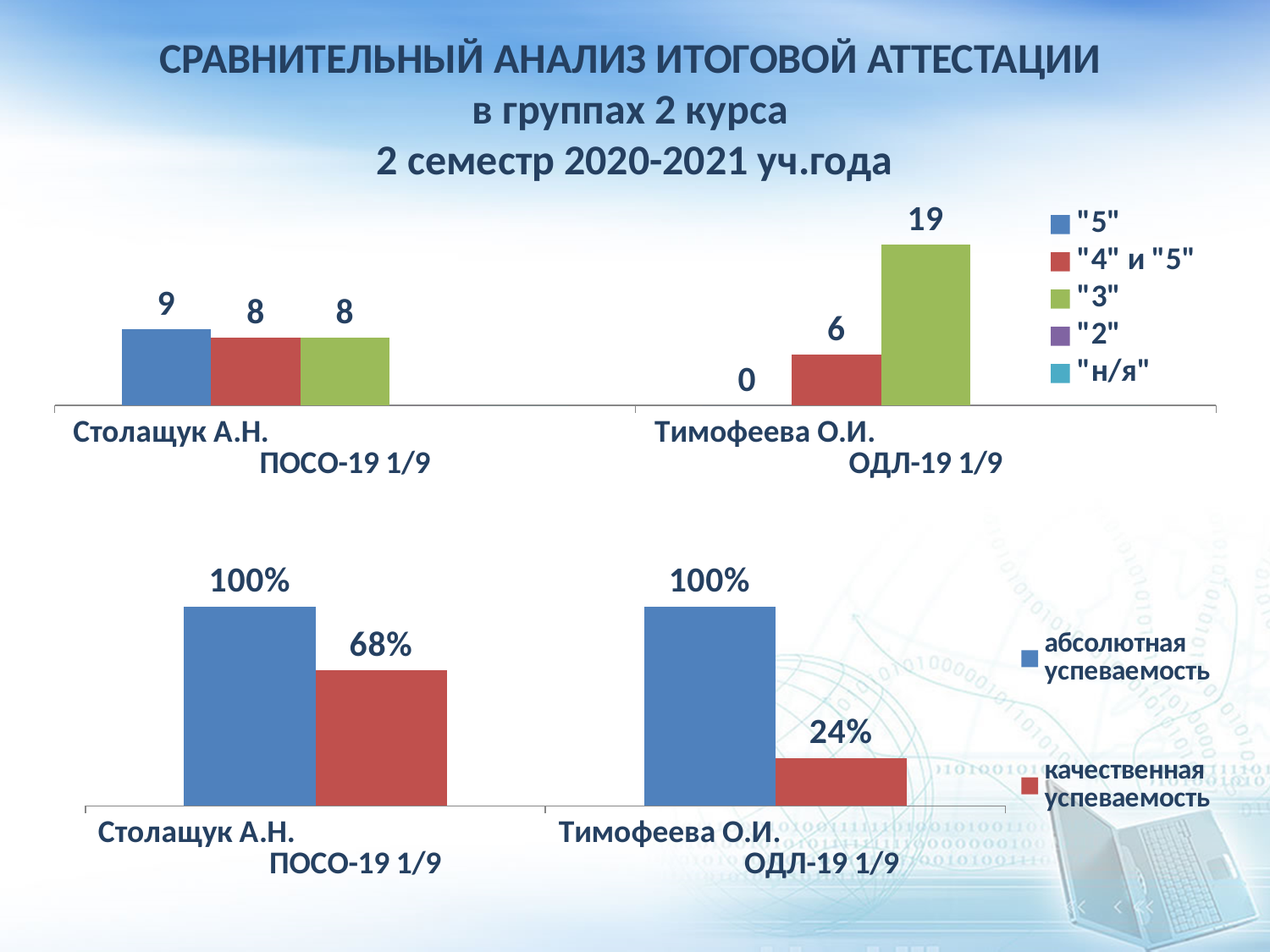
How many series does the legend of the bottom chart list? 2 In the top chart, how many students in group ПОСО-19 1/9 (Столащук А.Н.) received "5"? 9 In the bottom chart, which group has the lower качественная успеваемость? ОДЛ-19 1/9 (Тимофеева О.И.) How many series does the legend of the top chart list? 5 In the bottom chart, what is the абсолютная успеваемость for group ПОСО-19 1/9 (Столащук А.Н.)? 100% In the bottom chart, what is the качественная успеваемость for group ОДЛ-19 1/9 (Тимофеева О.И.)? 24% In the top chart, what is the value for "5" in group ОДЛ-19 1/9 (Тимофеева О.И.)? 0 In the top chart, how many students in group ОДЛ-19 1/9 (Тимофеева О.И.) received "3"? 19 In the bottom chart, what is the difference in качественная успеваемость between ПОСО-19 1/9 and ОДЛ-19 1/9? 44% In the top chart, which group has the larger value for "4" и "5": ПОСО-19 1/9 or ОДЛ-19 1/9? ПОСО-19 1/9 In the top chart, what is the difference between the "3" values for ОДЛ-19 1/9 and ПОСО-19 1/9? 11 What kind of chart is the top chart? bar chart